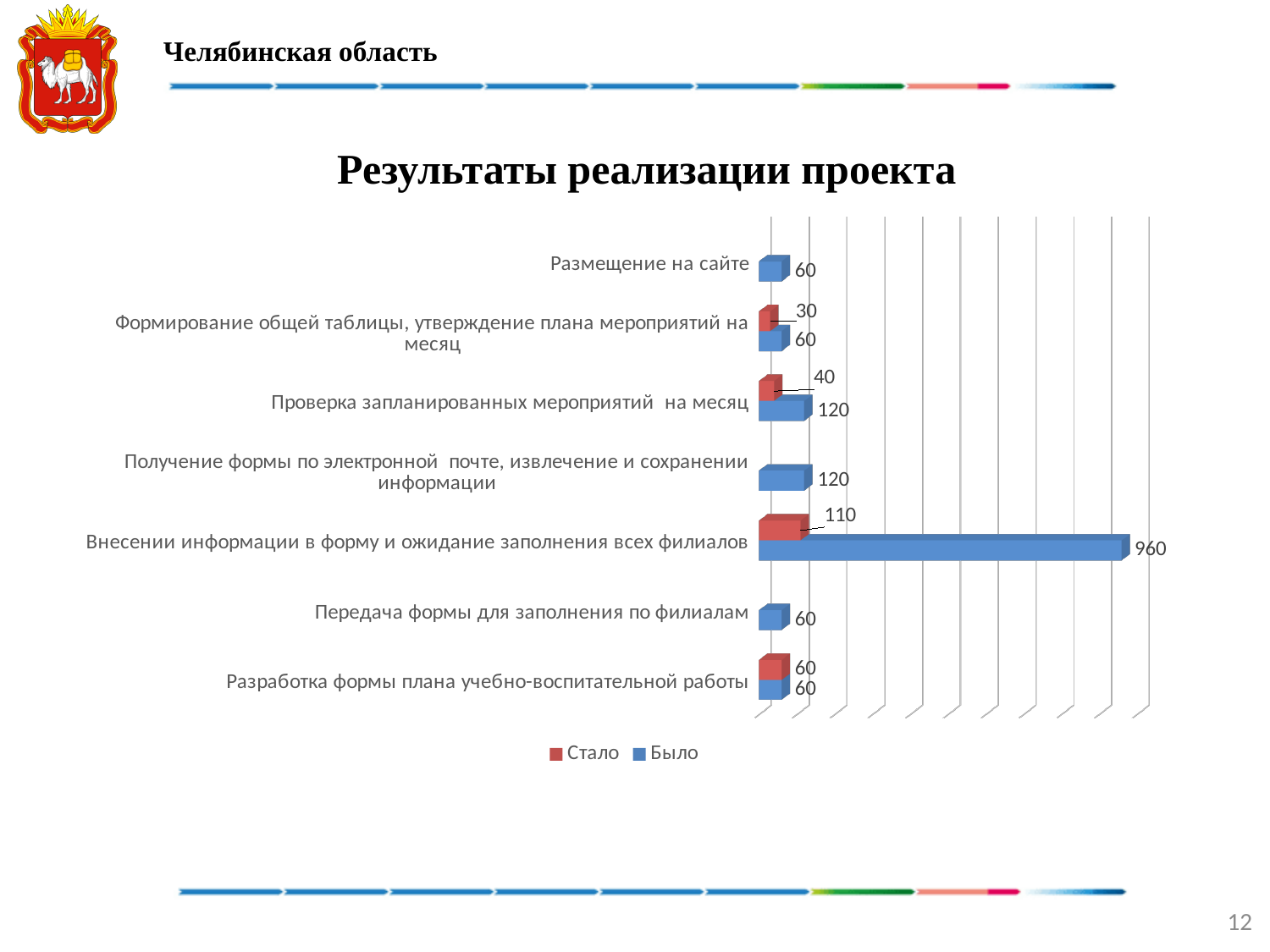
What is the 'Стало' value for 'Внесении информации в форму и ожидание заполнения всех филиалов'? 110 What is the 'Было' value for 'Внесении информации в форму и ожидание заполнения всех филиалов'? 960 What is the difference between the 'Было' and 'Стало' values for 'Проверка запланированных мероприятий на месяц'? 80 How many series does the legend list? 2 What kind of chart is shown on the slide? bar chart What is the 'Стало' value for 'Проверка запланированных мероприятий на месяц'? 40 What is the 'Было' value for 'Получение формы по электронной почте, извлечение и сохранении информации'? 120 Which category has the highest 'Было' value? Внесении информации в форму и ожидание заполнения всех филиалов Which is larger for 'Внесении информации в форму и ожидание заполнения всех филиалов': the 'Было' value or the 'Стало' value? Было What is the 'Стало' value for 'Формирование общей таблицы, утверждение плана мероприятий на месяц'? 30 How many categories are shown on the chart? 7 What is the title of the chart? Результаты реализации проекта